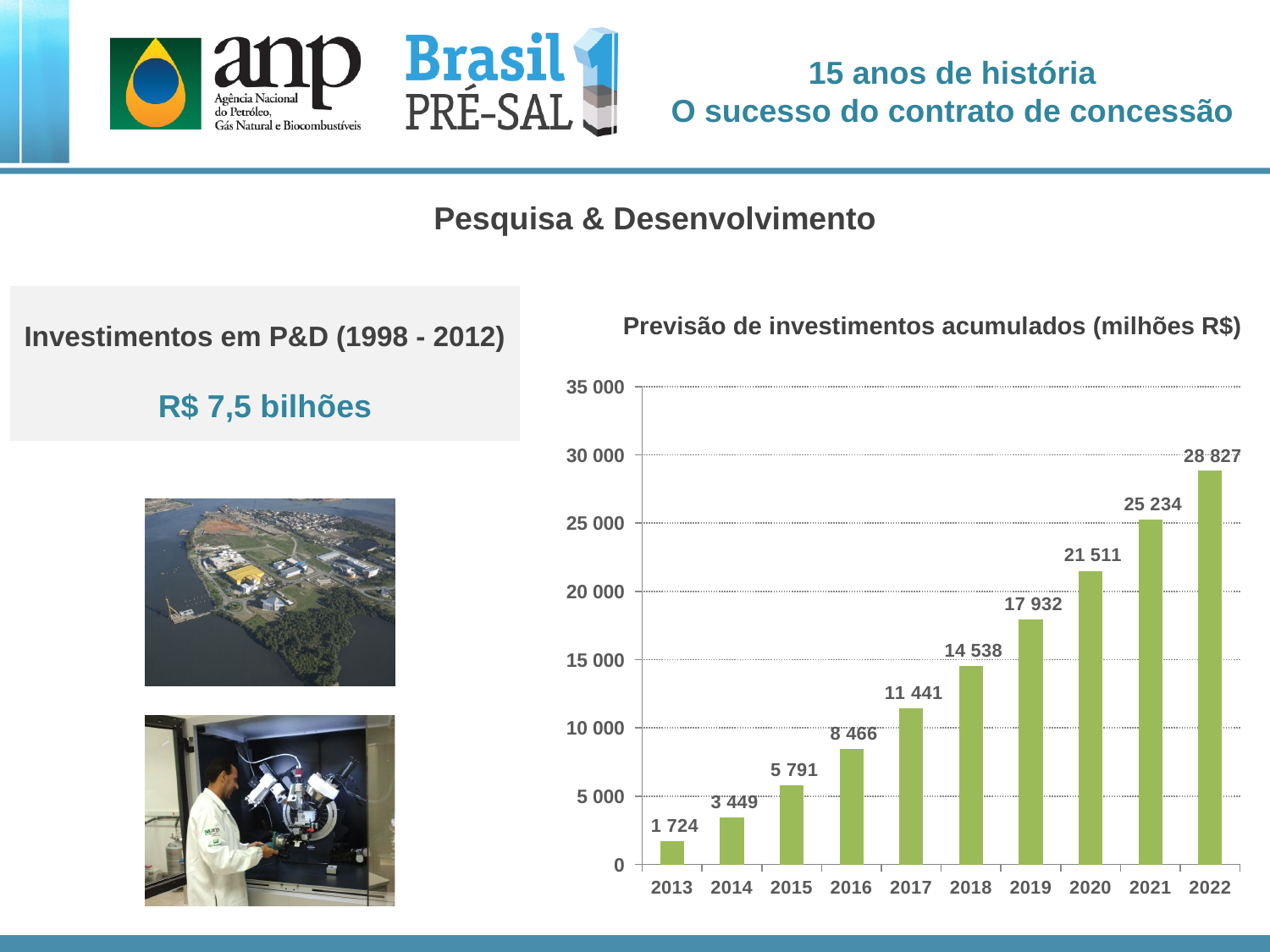
Do the forecast accumulated investments rise or fall from 2013 to 2022? Rise Which year has the highest forecast accumulated investment? 2022 What is the forecast accumulated investment for 2017? 11 441 Which is larger, the forecast accumulated investment for 2018 or for 2019? 2019 What is the difference between the forecast accumulated investment for 2022 and 2021? 3 593 How many years are shown on the x axis of the chart? 10 What kind of chart is used to show the forecast accumulated investments? Bar chart What is the difference between the forecast accumulated investment for 2016 and 2015? 2 675 Is the forecast accumulated investment for 2019 greater or less than 15 000? greater What is the forecast accumulated investment for 2020? 21 511 What is the forecast accumulated investment for 2013? 1 724 Which year has the lowest forecast accumulated investment? 2013